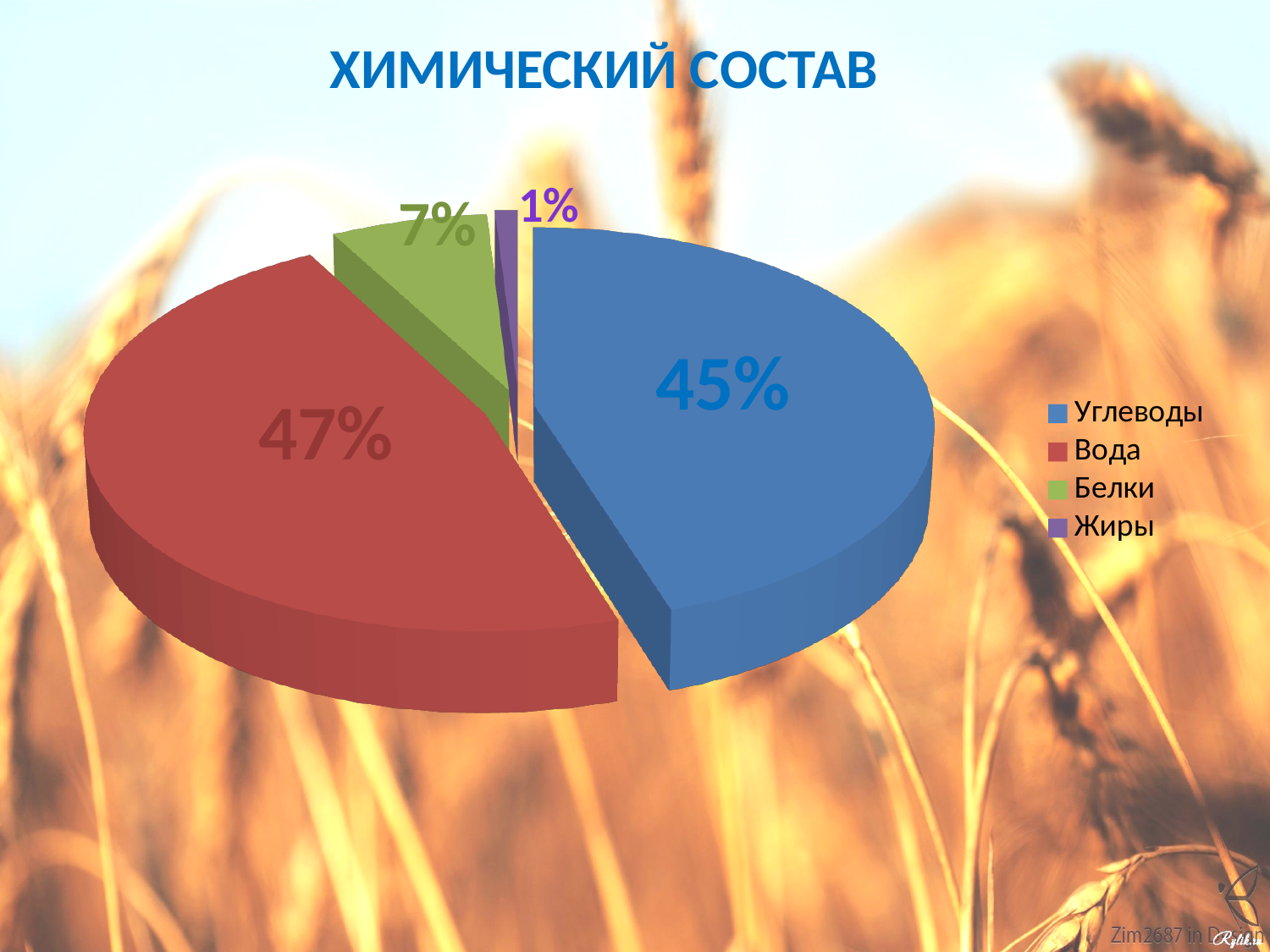
What is the value for Белки? 7% What is the title of the chart? ХИМИЧЕСКИЙ СОСТАВ What is the value for Вода? 47% What is the value for Углеводы? 45% What is the difference between the values for Белки and Жиры? 6% What is the value for Жиры? 1% Which is larger, the value for Белки or the value for Жиры? Белки What is the difference between the values for Вода and Углеводы? 2% What type of chart is shown on the slide? pie chart Which category has the largest share of the pie? Вода Which category has the smallest share of the pie? Жиры How many categories does the legend list? 4